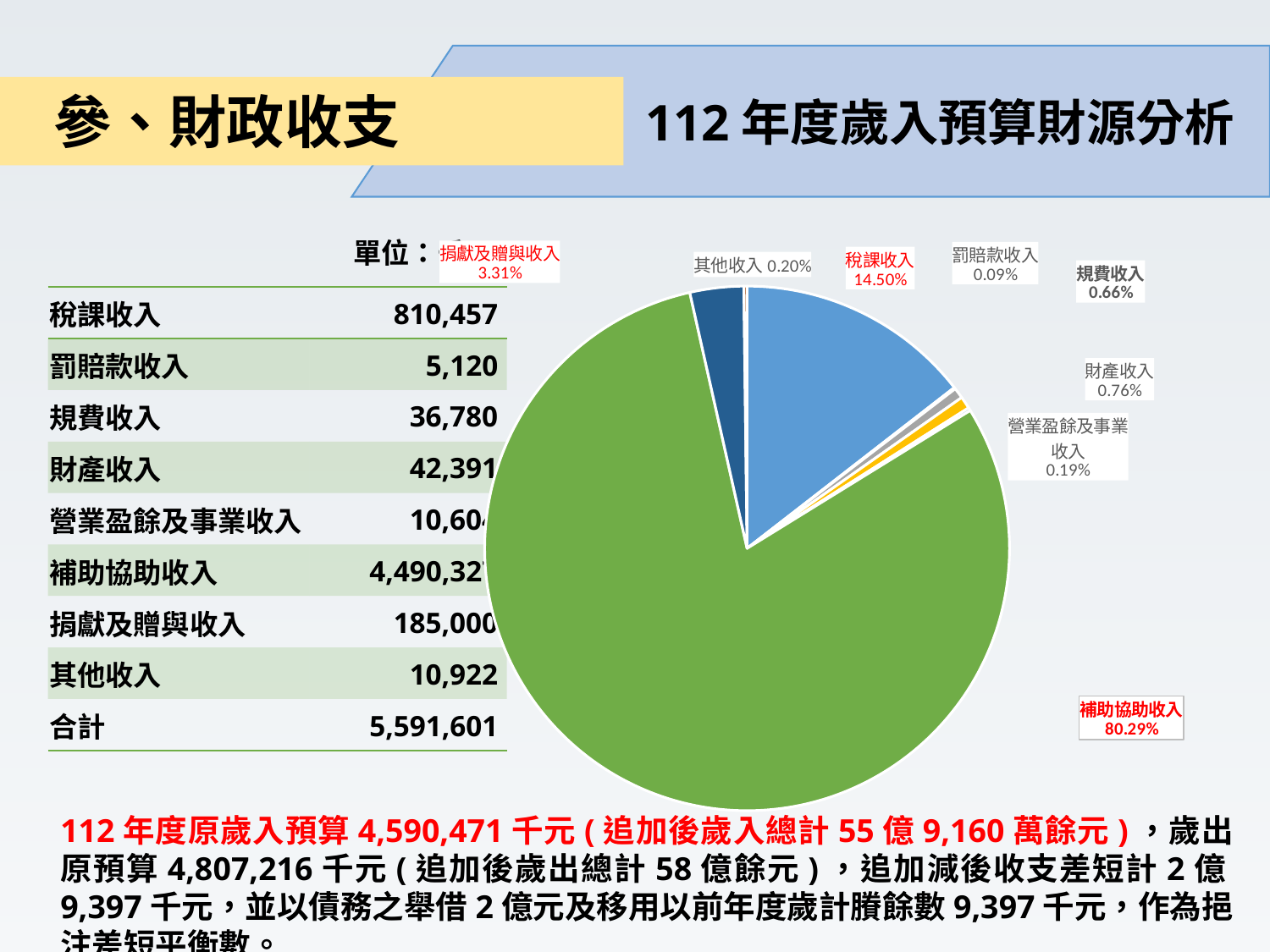
What is the percentage label for 罰賠款收入 in the pie chart? 0.09% What kind of chart is shown on the slide? pie chart Which category has the smallest slice of the pie? 罰賠款收入 What is the difference in percentage points between 補助協助收入 and 稅課收入 in the pie chart? 65.79 What share of the pie does 稅課收入 represent? 14.50% What share of the pie does 補助協助收入 represent? 80.29% Which is larger in the pie chart, 稅課收入 or 捐獻及贈與收入? 稅課收入 Which category has the largest slice of the pie? 補助協助收入 What is the title shown in the blue banner above the chart? 112 年度歲入預算財源分析 What is the percentage label for 財產收入 in the pie chart? 0.76% What is the percentage label for 捐獻及贈與收入 in the pie chart? 3.31% How many slices does the pie chart have? 8